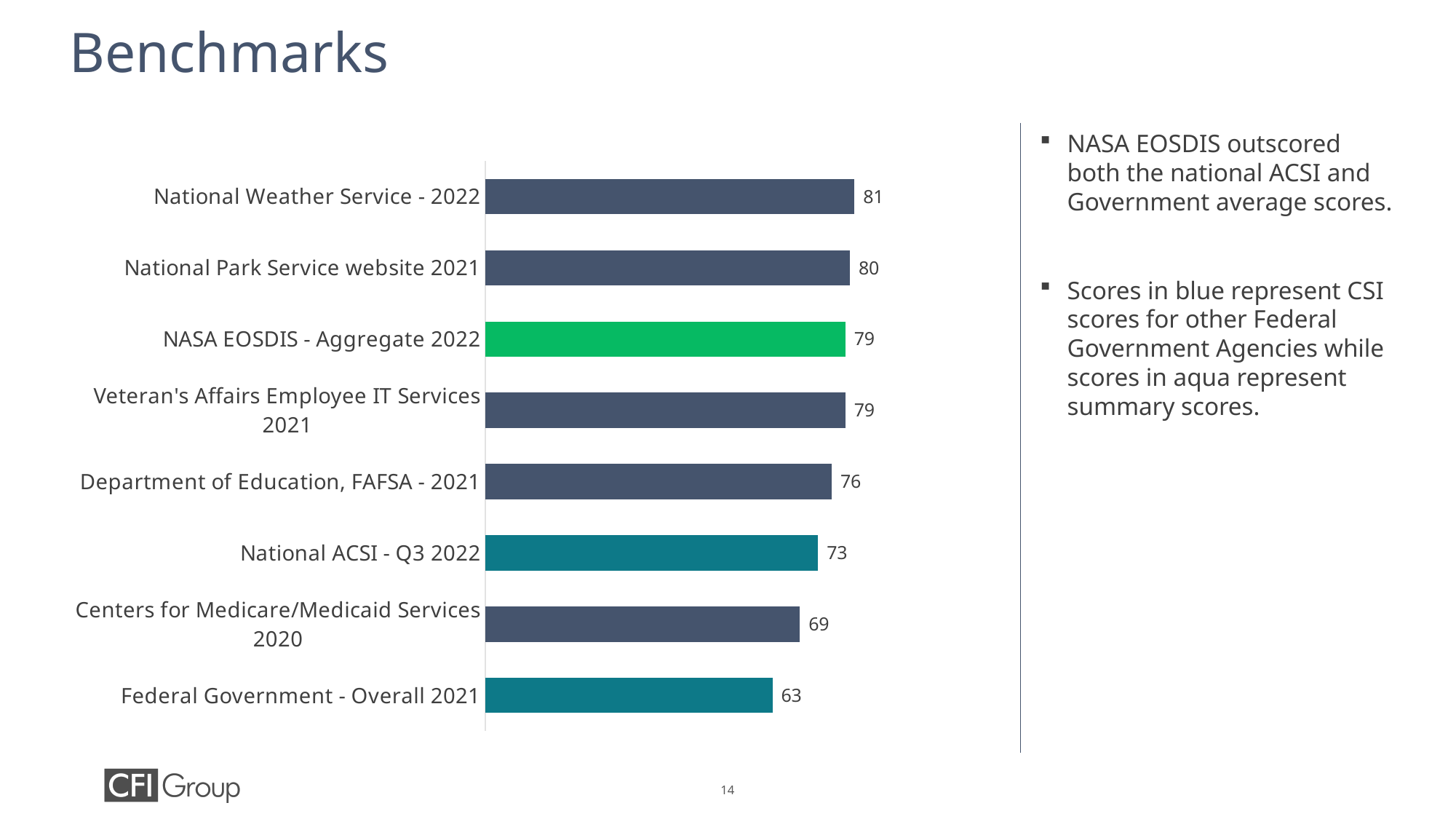
What is the difference between the values for National Weather Service - 2022 and Federal Government - Overall 2021? 18 Which category has the lowest value? Federal Government - Overall 2021 What is the value for National Weather Service - 2022? 81 What is the value for Federal Government - Overall 2021? 63 Which category has the highest value? National Weather Service - 2022 What is the value for National ACSI - Q3 2022? 73 What is the difference between the values for NASA EOSDIS - Aggregate 2022 and National ACSI - Q3 2022? 6 What kind of chart is shown on the slide? Bar chart What is the value for NASA EOSDIS - Aggregate 2022? 79 How many categories are shown in the chart? 8 Which is larger, the value for Department of Education, FAFSA - 2021 or the value for Centers for Medicare/Medicaid Services 2020? Department of Education, FAFSA - 2021 Which bar in the chart is coloured green? NASA EOSDIS - Aggregate 2022